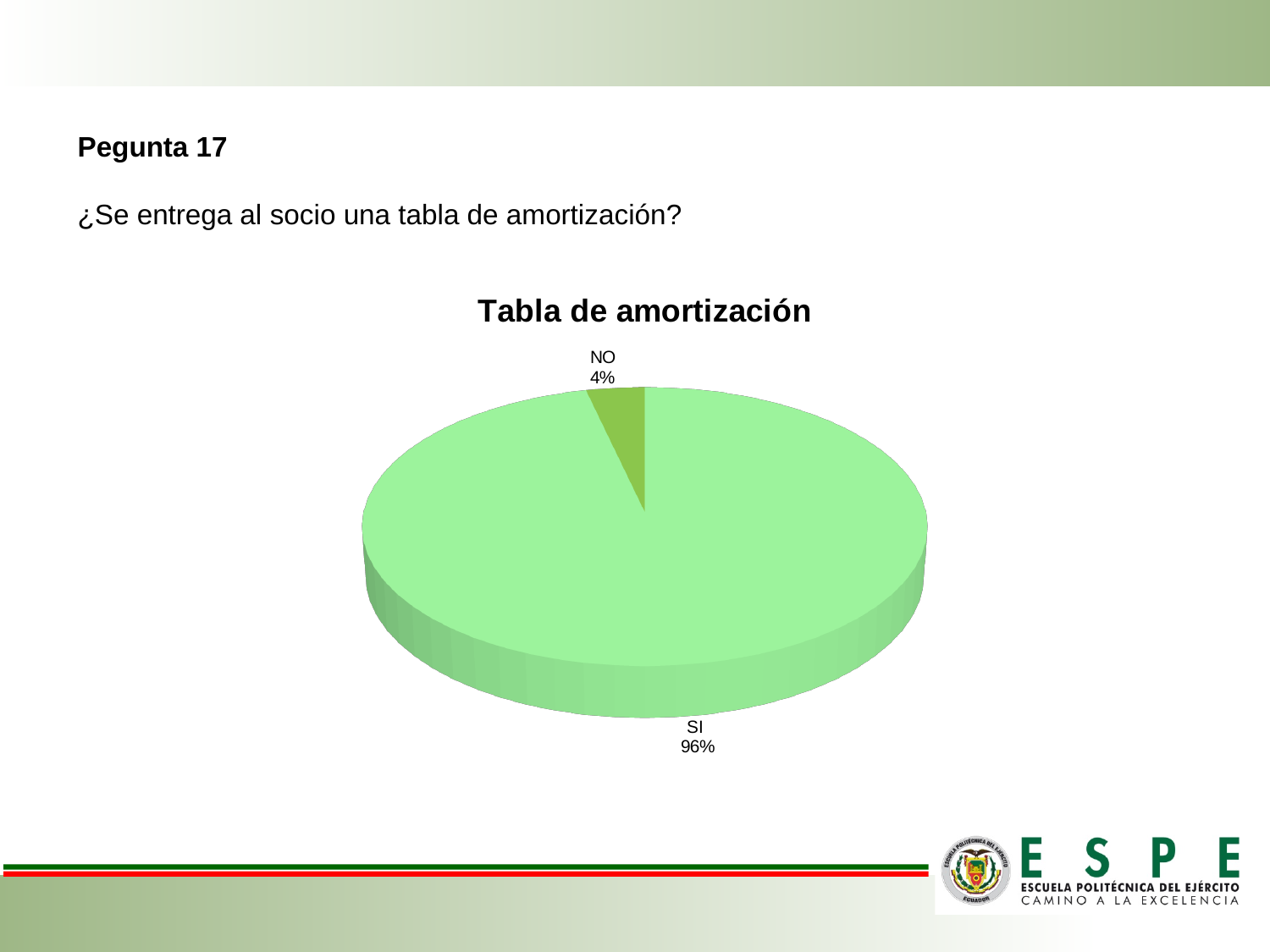
What kind of chart is shown on the slide? pie chart How many slices does the pie chart have? 2 What is the combined percentage of the SI and NO slices? 100% What is the difference in percentage points between the SI and NO slices? 92 Which is larger, the SI slice or the NO slice? SI What percentage of the pie corresponds to NO? 4% What percentage of the pie corresponds to SI? 96% Which slice is the largest in the pie chart? SI What is the title of the chart? Tabla de amortización What share of the pie does the NO slice represent? 4% Which slice is the smallest in the pie chart? NO